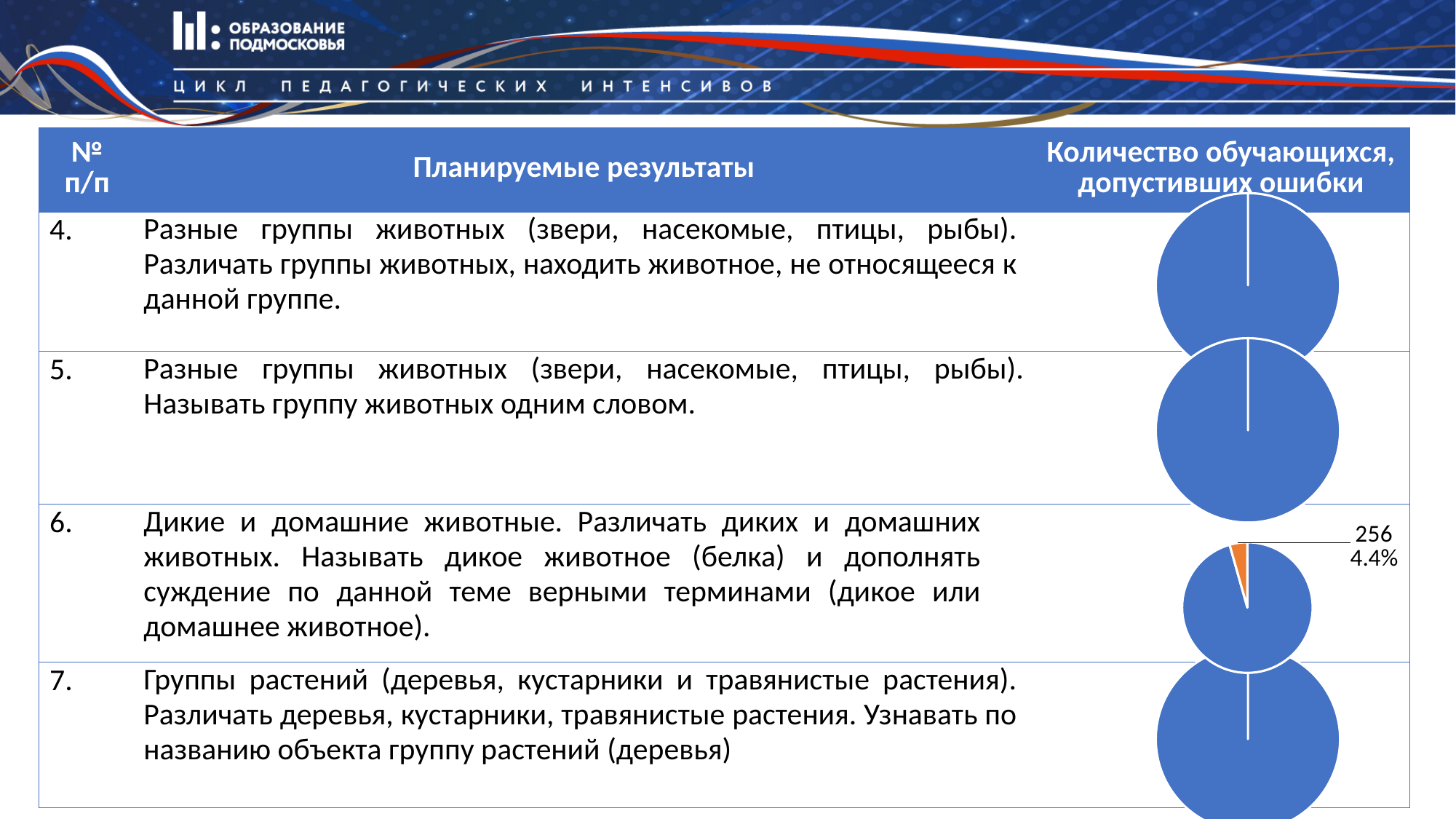
In the pie chart for item 6, what percentage share is printed for the orange slice? 4.4% In the pie chart for item 6, what value is printed on the orange slice's data label? 256 How many pie charts are shown in the right-hand column of the table? 4 What colour is the dominant slice in each of the four pie charts? blue Which of the four pie charts is the only one with a printed data label? the pie chart for item 6 What kind of chart is shown in the row for item 6? pie chart How many visibly distinct slices does the pie chart for item 6 have? 2 In the pie chart for item 6, is the share of the orange slice greater or less than 50%? less In the pie chart for item 6, which slice is larger, the blue one or the orange one? blue